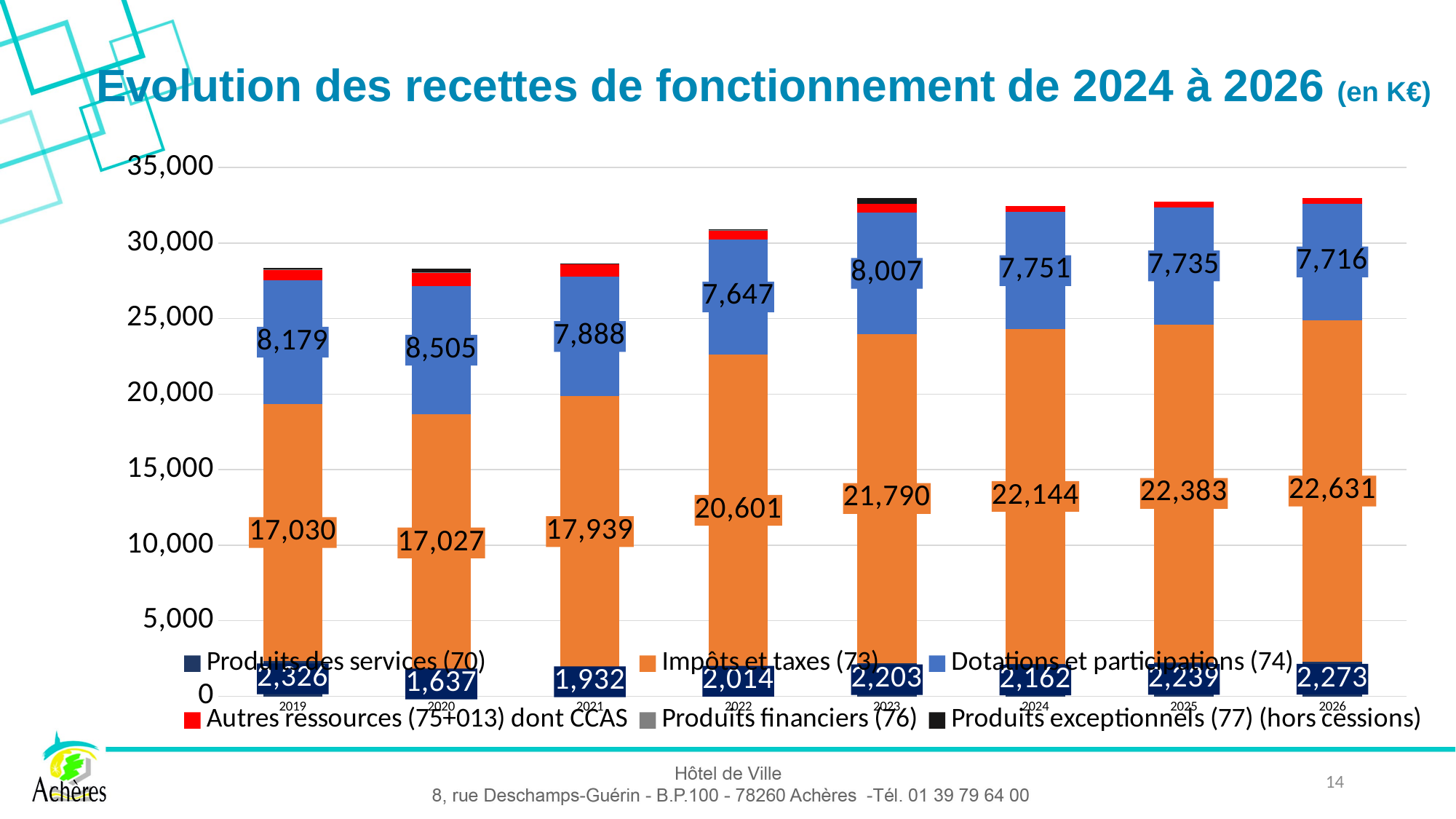
What is the difference between Impôts et taxes (73) in 2026 and in 2024? 487 How many series does the legend list? 6 Is the total height of the stacked bar for 2023 greater or less than 30,000? greater How many years are shown on the x axis? 8 What is the value of Dotations et participations (74) for 2023? 8,007 What is the value of Produits des services (70) for 2020? 1,637 In which year is Impôts et taxes (73) highest? 2026 Does Impôts et taxes (73) rise or fall from 2021 to 2026? Rise Which is larger: Dotations et participations (74) in 2020 or in 2019? 2020 What kind of chart is shown on the slide? Stacked bar chart In which year is Produits des services (70) lowest? 2020 What is the value of Impôts et taxes (73) for 2026? 22,631